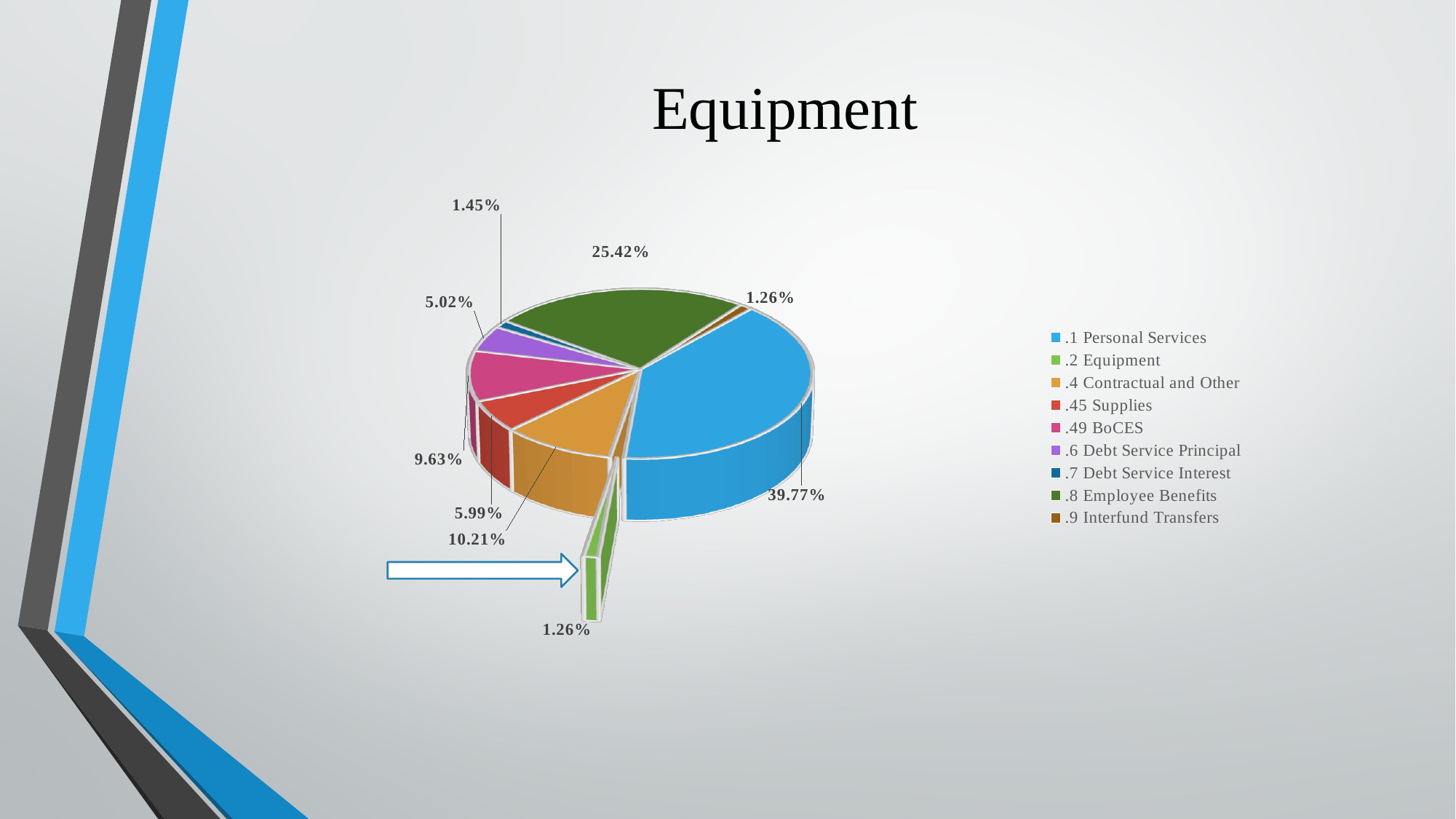
What is the title of the chart? Equipment What is the difference between the shares of .1 Personal Services and .8 Employee Benefits? 14.35% What percentage of the pie is the exploded .2 Equipment slice? 1.26% Which slice is pulled out from the pie and pointed to by the arrow? .2 Equipment What percentage of the pie is .49 BoCES? 9.63% Which category has the largest share of the pie? .1 Personal Services What percentage of the pie is .8 Employee Benefits? 25.42% Which has a larger share, .45 Supplies or .6 Debt Service Principal? .45 Supplies What percentage of the pie is .1 Personal Services? 39.77% What percentage of the pie is .4 Contractual and Other? 10.21% How many categories does the legend list? 9 What type of chart is shown on the slide? pie chart